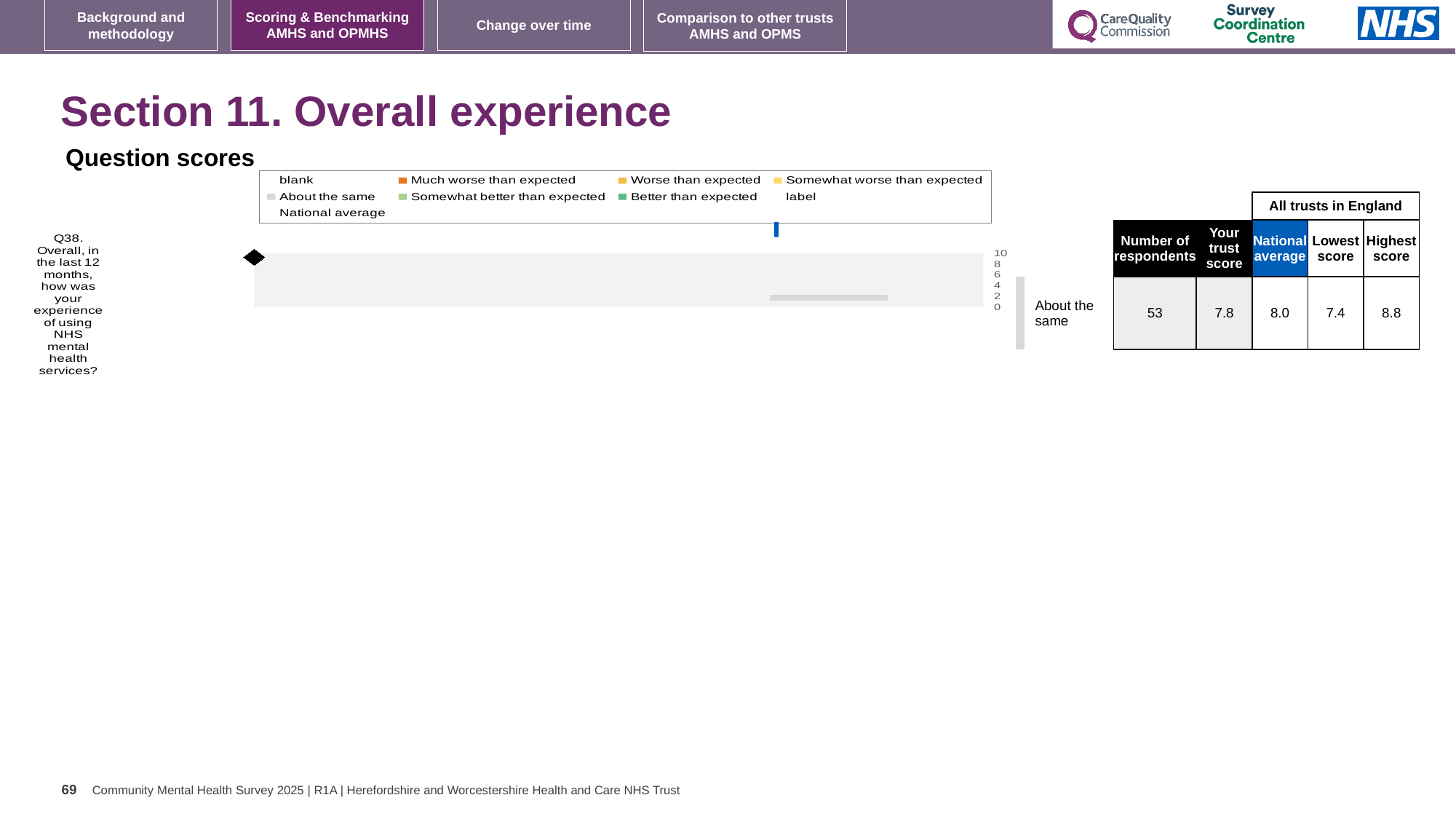
What is the national average score for Q38? 8.0 What is the 'Your trust score' value for Q38? 7.8 How many survey questions are plotted in the Question scores chart? 1 What is the difference between the highest and lowest scores for Q38? 1.4 How many respondents answered Q38? 53 Which is larger for Q38: the trust score or the national average? national average What kind of chart is shown under 'Question scores'? bar chart By how much does the national average exceed the trust score for Q38? 0.2 What is the highest score among all trusts in England for Q38? 8.8 Is the trust score for Q38 greater or less than 6 on the chart's axis? greater Which benchmark category is shown for Q38 in the Question scores chart? About the same What is the lowest score among all trusts in England for Q38? 7.4